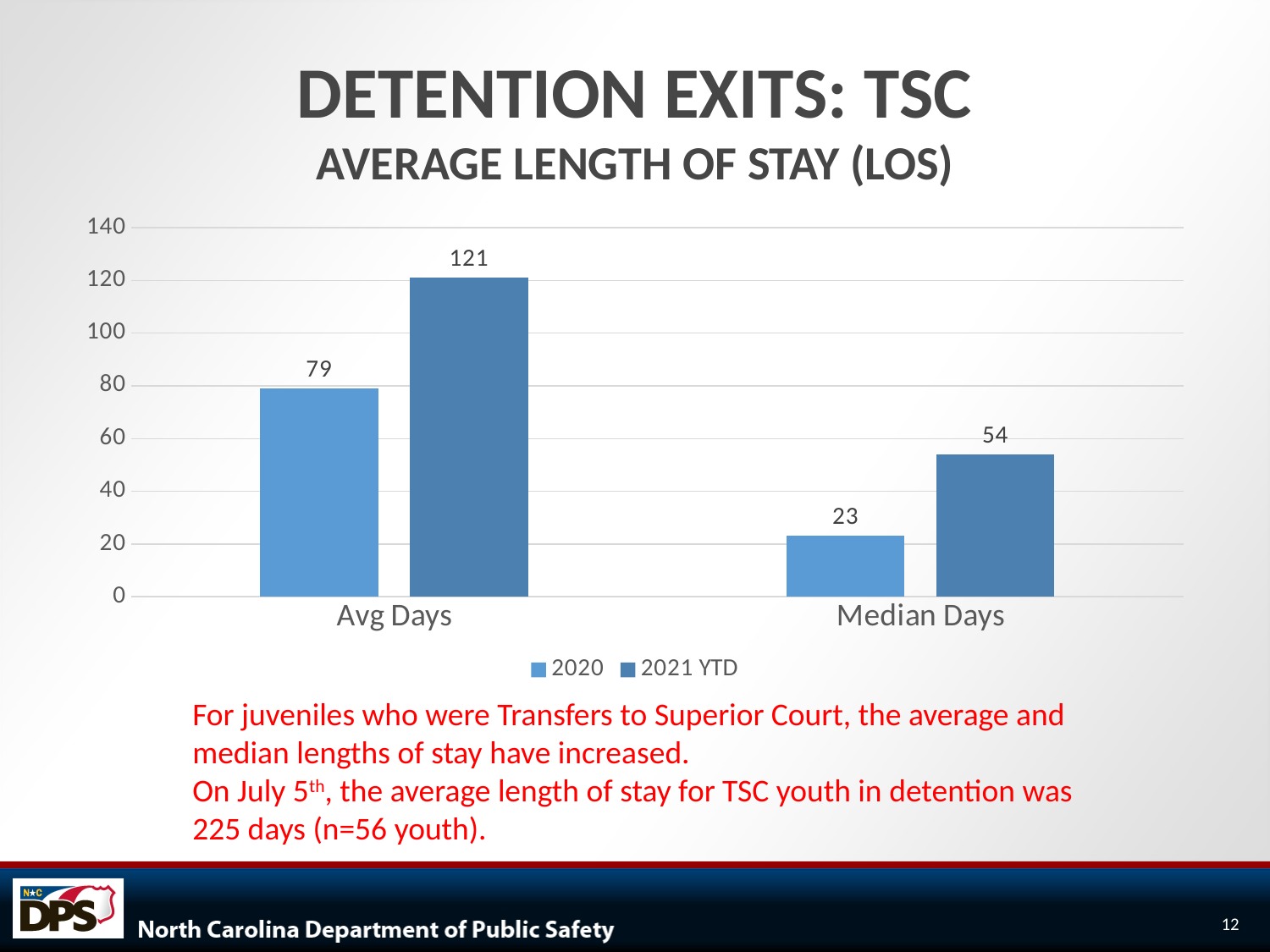
How many categories are shown on the x axis? 2 What is the value for 2020 in the Avg Days category? 79 What is the value for 2021 YTD in the Avg Days category? 121 What is the value for 2020 in the Median Days category? 23 Which bar has the highest value on the chart? 2021 YTD, Avg Days What is the difference between the 2021 YTD and 2020 values for Avg Days? 42 Which is larger: the 2020 value for Avg Days or the 2021 YTD value for Median Days? 2020 value for Avg Days How many series does the legend list? 2 What kind of chart is shown on the slide? Bar chart Which bar has the lowest value on the chart? 2020, Median Days What is the value for 2021 YTD in the Median Days category? 54 What is the difference between the 2021 YTD and 2020 values for Median Days? 31